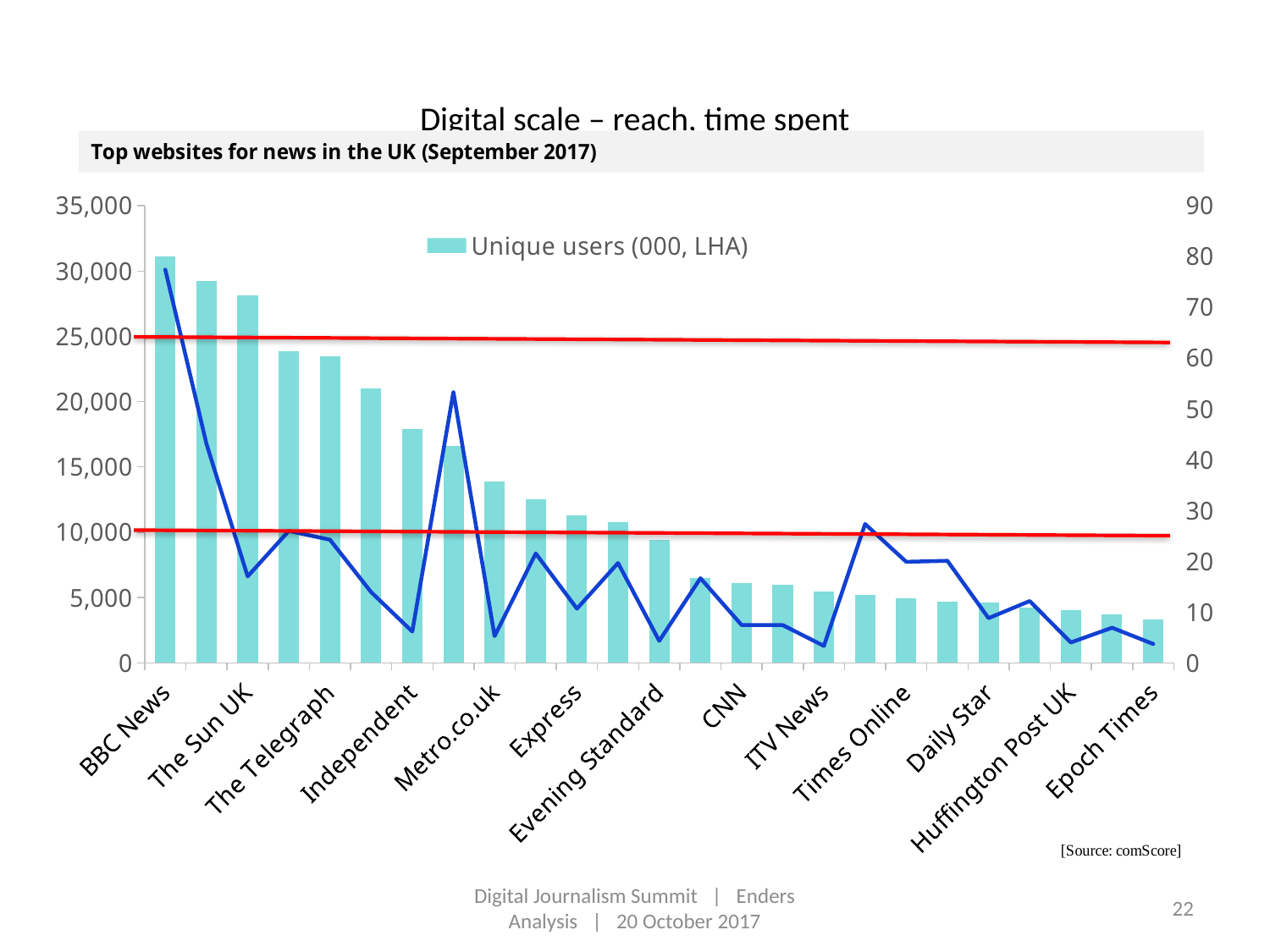
Is the unique users value for The Sun UK greater or less than 25,000? greater Which website has the highest number of unique users? BBC News What is the source cited for the chart? comScore Do the unique users bars rise or fall from left to right across the chart? fall Is the unique users value for Independent greater or less than 20,000? less Which has more unique users, The Sun UK or Independent? The Sun UK Is the unique users value for Huffington Post UK greater or less than 5,000? less What is the title of the chart? Top websites for news in the UK (September 2017) How many series does the legend list? 1 Which labelled website has the lowest number of unique users? Epoch Times